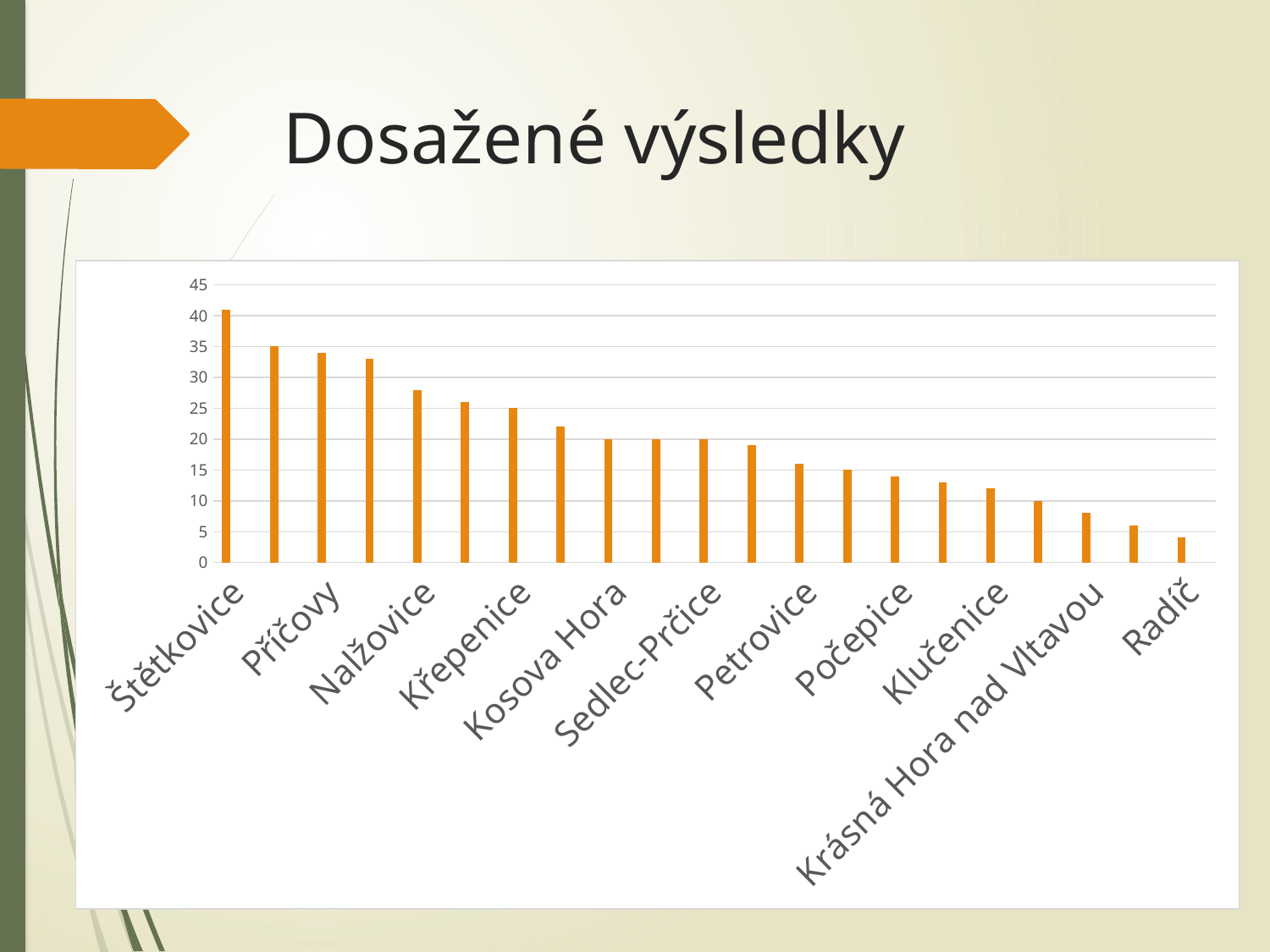
Is the value for Krásná Hora nad Vltavou greater or less than 10? less What is the title of the chart? Dosažené výsledky Which is larger, the value for Příčovy or the value for Petrovice? Příčovy How many bars are plotted in the chart? 21 What kind of chart is shown on the slide? bar chart What is the value for Kosova Hora? 20 Which category has the highest value? Štětkovice Is the value for Nalžovice greater or less than 25? greater Is the value for Radíč greater or less than 5? less Do the values rise or fall from left to right along the x axis? fall Which category has the lowest value? Radíč